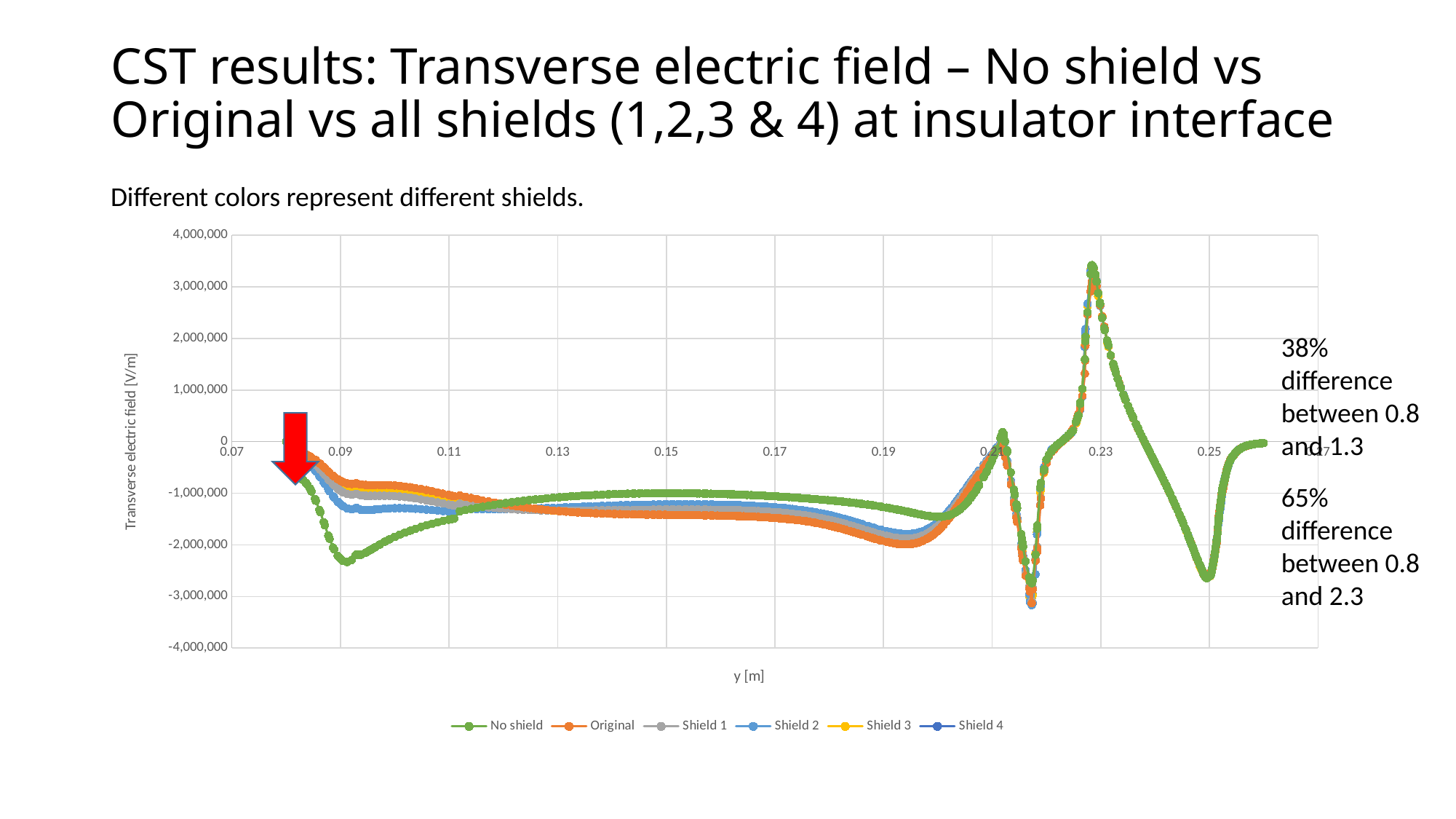
Between y = 0.23 and y = 0.25, does the No shield series rise or fall? fall Is the peak value of the No shield series near y = 0.23 greater or less than 3,000,000? greater Is the minimum of the No shield series near y = 0.25 greater or less than -2,000,000? less At y = 0.09, which series has the lower value, No shield or Original? No shield What is the label of the vertical axis? Transverse electric field [V/m] What kind of chart is shown on the slide? Line chart How many series does the legend list? 6 Which series reaches the highest peak near y = 0.23? No shield Is the value of the Original series at y = 0.19 greater or less than -1,000,000? less Near y = 0.195, which series dips lower, No shield or Original? Original What are the series names listed in the legend? No shield, Original, Shield 1, Shield 2, Shield 3, Shield 4